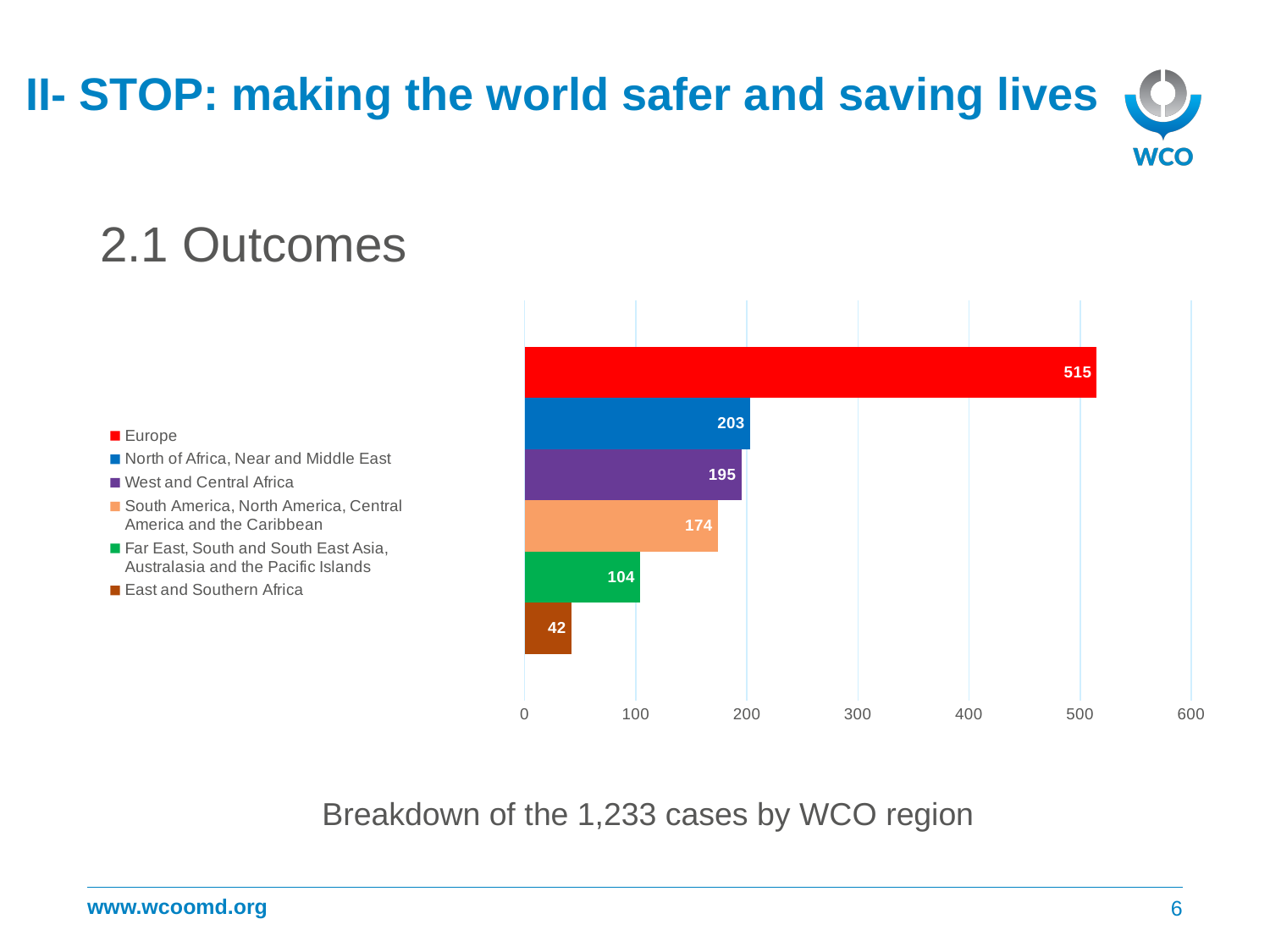
Which is larger, the value for West and Central Africa or the value for South America, North America, Central America and the Caribbean? West and Central Africa What is the value for Europe? 515 Which region has the highest value? Europe What is the value for Far East, South and South East Asia, Australasia and the Pacific Islands? 104 What is the value for North of Africa, Near and Middle East? 203 Is the value for West and Central Africa greater or less than 200? less What is the value for East and Southern Africa? 42 What kind of chart is shown on the slide? bar chart How many regions are shown in the chart? 6 What is the difference between the values for Europe and North of Africa, Near and Middle East? 312 Which region has the lowest value? East and Southern Africa What colour is the bar for Europe? red